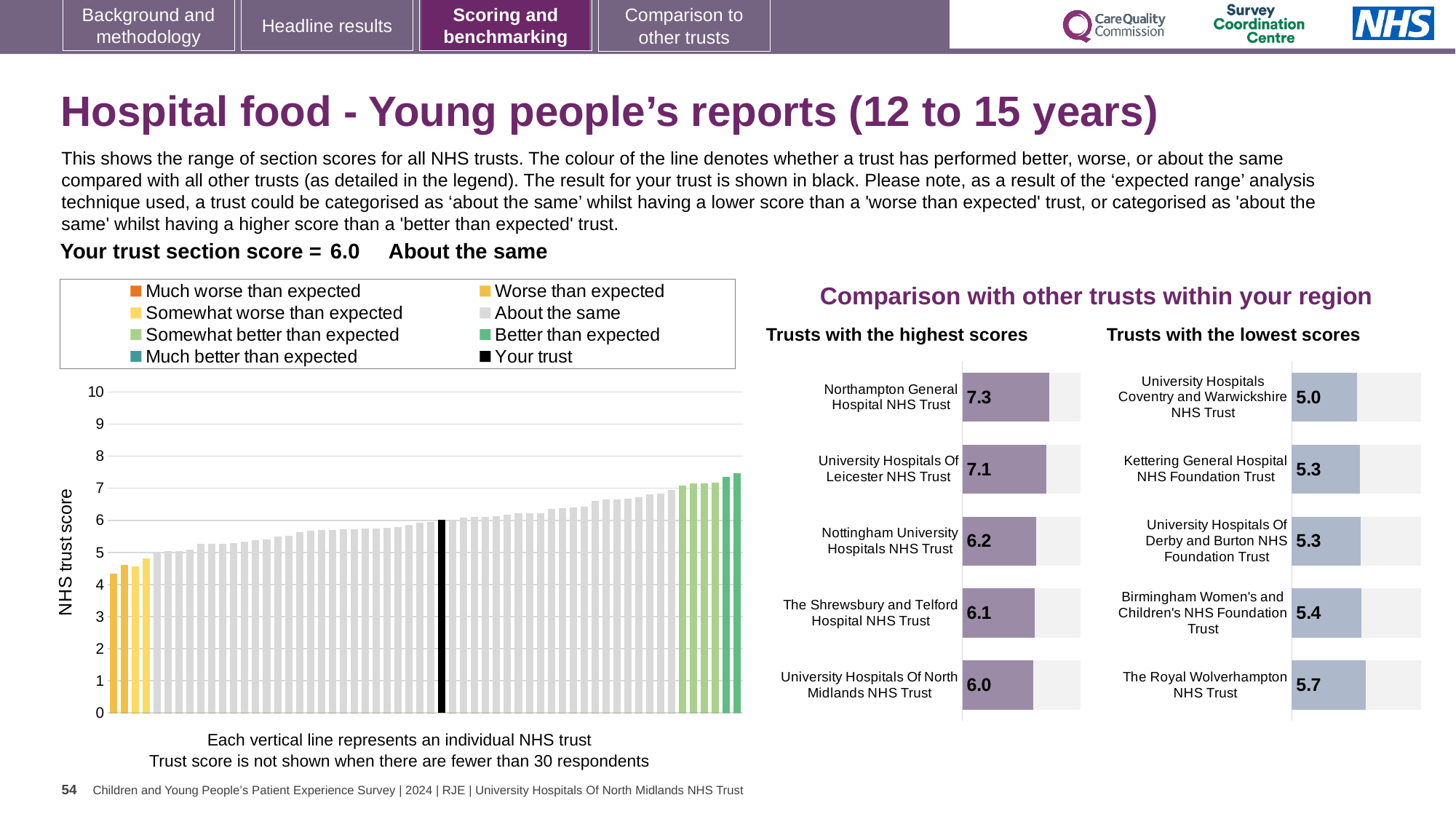
How many trusts are listed in the 'Trusts with the lowest scores' chart? 5 In the 'Trusts with the highest scores' chart, what is the difference between the scores of Northampton General Hospital NHS Trust and University Hospitals Of North Midlands NHS Trust? 1.3 In the 'Trusts with the highest scores' chart, which has the higher score: Nottingham University Hospitals NHS Trust or The Shrewsbury and Telford Hospital NHS Trust? Nottingham University Hospitals NHS Trust In the main chart on the left, what is the section score for your trust (the black bar)? 6.0 In the main chart on the left, is the value of the tallest green bar greater or less than 7? greater In the 'Trusts with the lowest scores' chart, what is the score for The Royal Wolverhampton NHS Trust? 5.7 In the 'Trusts with the lowest scores' chart, which trust has the lowest score? University Hospitals Coventry and Warwickshire NHS Trust In the 'Trusts with the highest scores' chart, what is the score for Northampton General Hospital NHS Trust? 7.3 In the 'Trusts with the highest scores' chart, which trust has the highest score? Northampton General Hospital NHS Trust In the main chart on the left, do the trust scores rise or fall from left to right? rise How many entries does the legend of the main chart on the left list? 8 In the 'Trusts with the lowest scores' chart, what is the difference between the scores of The Royal Wolverhampton NHS Trust and University Hospitals Coventry and Warwickshire NHS Trust? 0.7